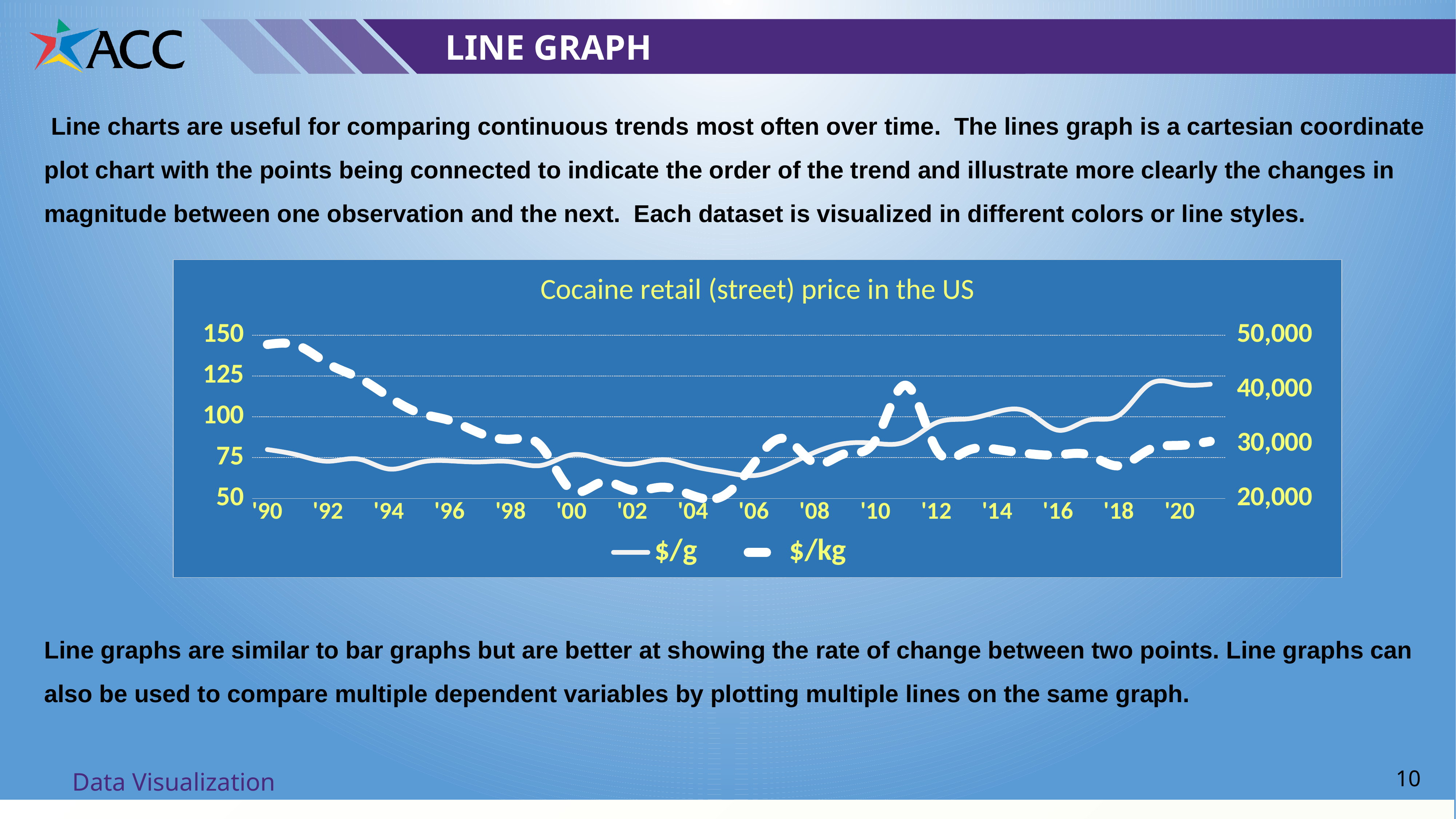
How many year labels are shown on the x axis? 16 Is the $/kg value in '90 greater or less than 40,000? greater Does the $/kg series rise or fall between '90 and '00? fall Is the $/kg value in '04 greater or less than 30,000? less How many series does the chart's legend list? 2 Is the $/g value in '20 greater or less than 100? greater What is the title of the chart? Cocaine retail (street) price in the US In which year is the $/kg series at its highest? '90 Which series is drawn with a dashed line? $/kg Which is larger for the $/g series: the value in '90 or the value in '20? '20 What kind of chart is shown on the slide? line chart